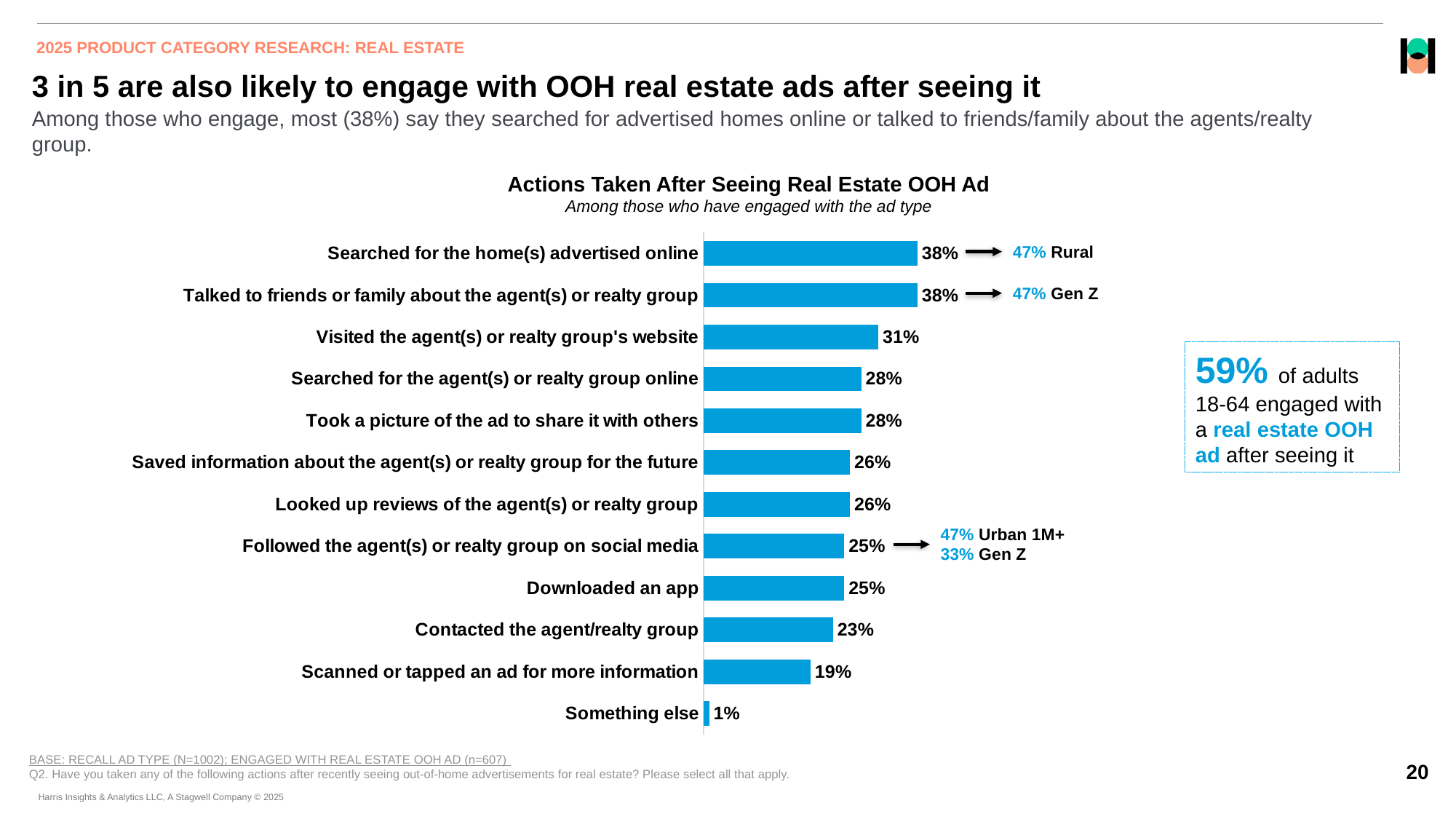
Which is larger: 'Searched for the agent(s) or realty group online' or 'Downloaded an app'? Searched for the agent(s) or realty group online What is the value for 'Took a picture of the ad to share it with others'? 28% What is the difference between 'Visited the agent(s) or realty group's website' and 'Contacted the agent/realty group'? 8% What is the difference between 'Searched for the home(s) advertised online' and 'Scanned or tapped an ad for more information'? 19% What type of chart is used on this slide? Bar chart Which action has the lowest value in the chart? Something else How many action categories are shown in the chart? 12 According to the callout next to 'Followed the agent(s) or realty group on social media', what is the value for Gen Z? 33% What is the value for 'Visited the agent(s) or realty group's website'? 31% What is the title of the chart? Actions Taken After Seeing Real Estate OOH Ad What percentage scanned or tapped an ad for more information? 19% What percentage of those who engaged searched for the home(s) advertised online? 38%